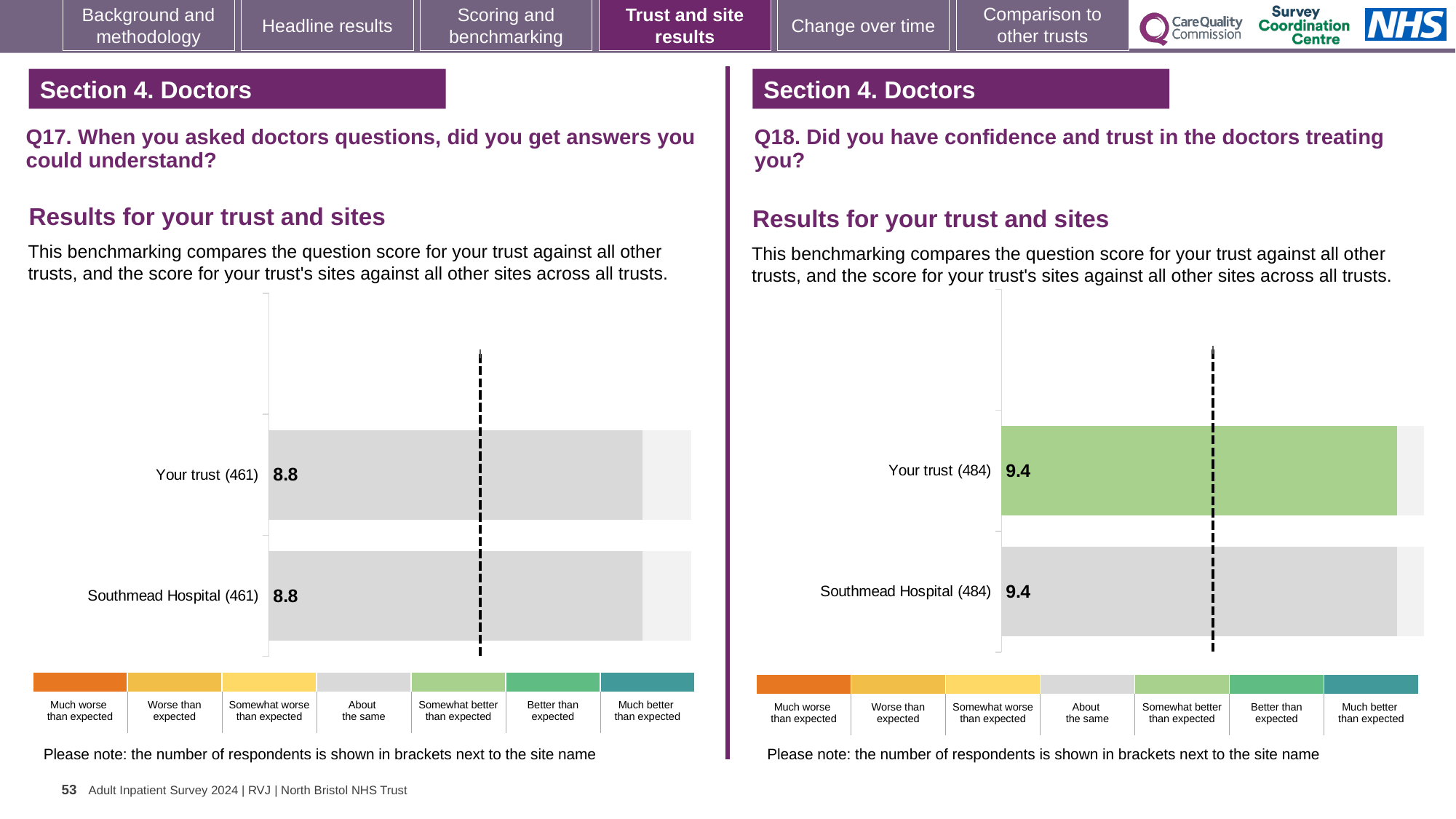
On the Q18 chart (right), what is the score for Southmead Hospital? 9.4 On the Q18 chart (right), what is the score for Your trust? 9.4 How many bars are plotted on the Q18 chart (right)? 2 What kind of chart is used on the Q18 chart (right)? Bar chart On the Q18 chart (right), how many respondents are shown in brackets next to Your trust? 484 On the Q18 chart (right), what is the difference between the Your trust score and the Southmead Hospital score? 0.0 How many bars are plotted on the Q17 chart (left)? 2 Is the Your trust score on the Q18 chart (right) larger or smaller than the Your trust score on the Q17 chart (left)? Larger On the Q17 chart (left), what is the score for Southmead Hospital? 8.8 On the Q17 chart (left), how many respondents are shown in brackets next to Southmead Hospital? 461 On the Q17 chart (left), what is the score for Your trust? 8.8 On the Q17 chart (left), what is the difference between the Your trust score and the Southmead Hospital score? 0.0